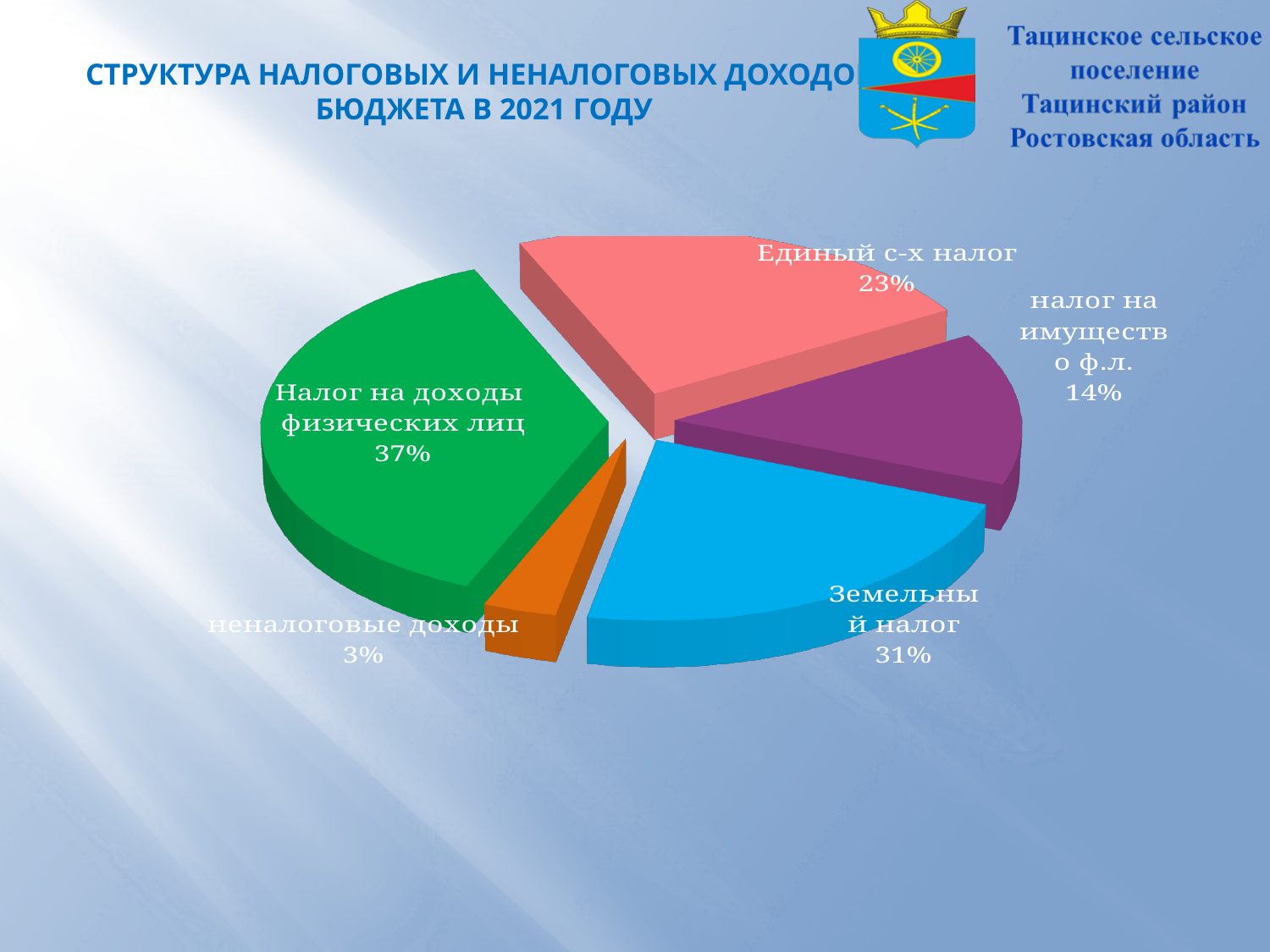
What kind of chart is shown on the slide? Pie chart Which category has the largest share of the pie? Налог на доходы физических лиц What share of the pie does "Земельный налог" have? 31% How many slices does the pie chart have? 5 What share of the pie does "Единый с-х налог" have? 23% What colour is the slice for "Земельный налог"? Blue Which is larger, the share for "Единый с-х налог" or the share for "налог на имущество ф.л."? Единый с-х налог What share of the pie does "налог на имущество ф.л." have? 14% What is the difference in percentage points between "Налог на доходы физических лиц" and "Земельный налог"? 6 Which category has the smallest share of the pie? неналоговые доходы